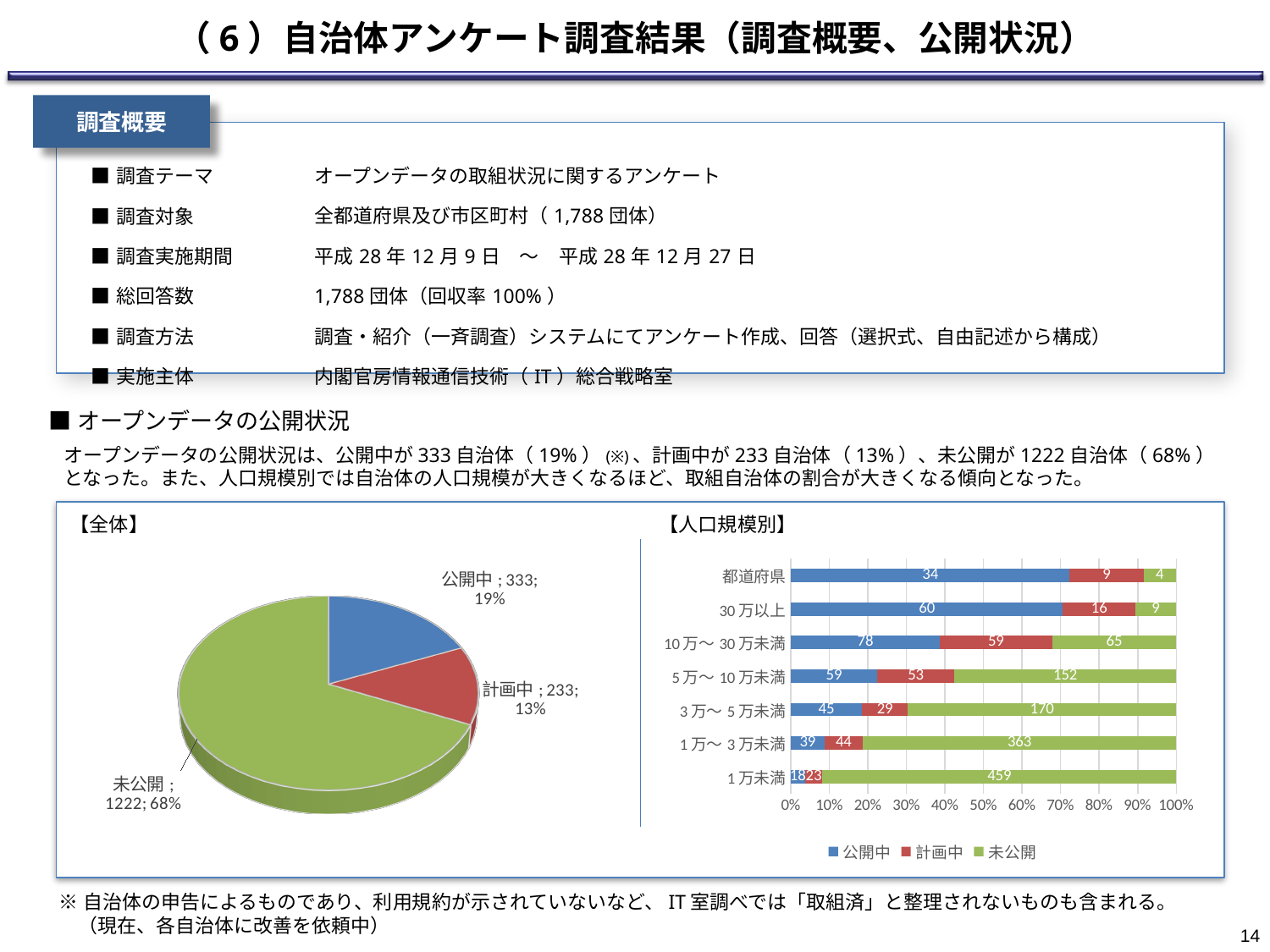
In the 【人口規模別】 chart, what is the 未公開 value for 1万～3万未満? 363 In the 【人口規模別】 chart, which is larger for 5万～10万未満: the 公開中 value or the 計画中 value? 公開中 In the 【人口規模別】 chart, what is the 公開中 value for 都道府県? 34 In the 【人口規模別】 chart, how many population-size categories are shown? 7 In the 【全体】 chart, what kind of chart is shown? pie chart In the 【全体】 chart, how many municipalities are in the 公開中 slice? 333 In the 【人口規模別】 chart, how many series does the legend list? 3 In the 【全体】 chart, what share of the pie does 未公開 represent? 68% In the 【全体】 chart, what is the difference between the 未公開 count and the 公開中 count? 889 In the 【人口規模別】 chart, what kind of chart is shown? stacked bar chart In the 【人口規模別】 chart, what is the total of the three segments for 10万～30万未満? 202 In the 【全体】 chart, which category has the smallest slice? 計画中